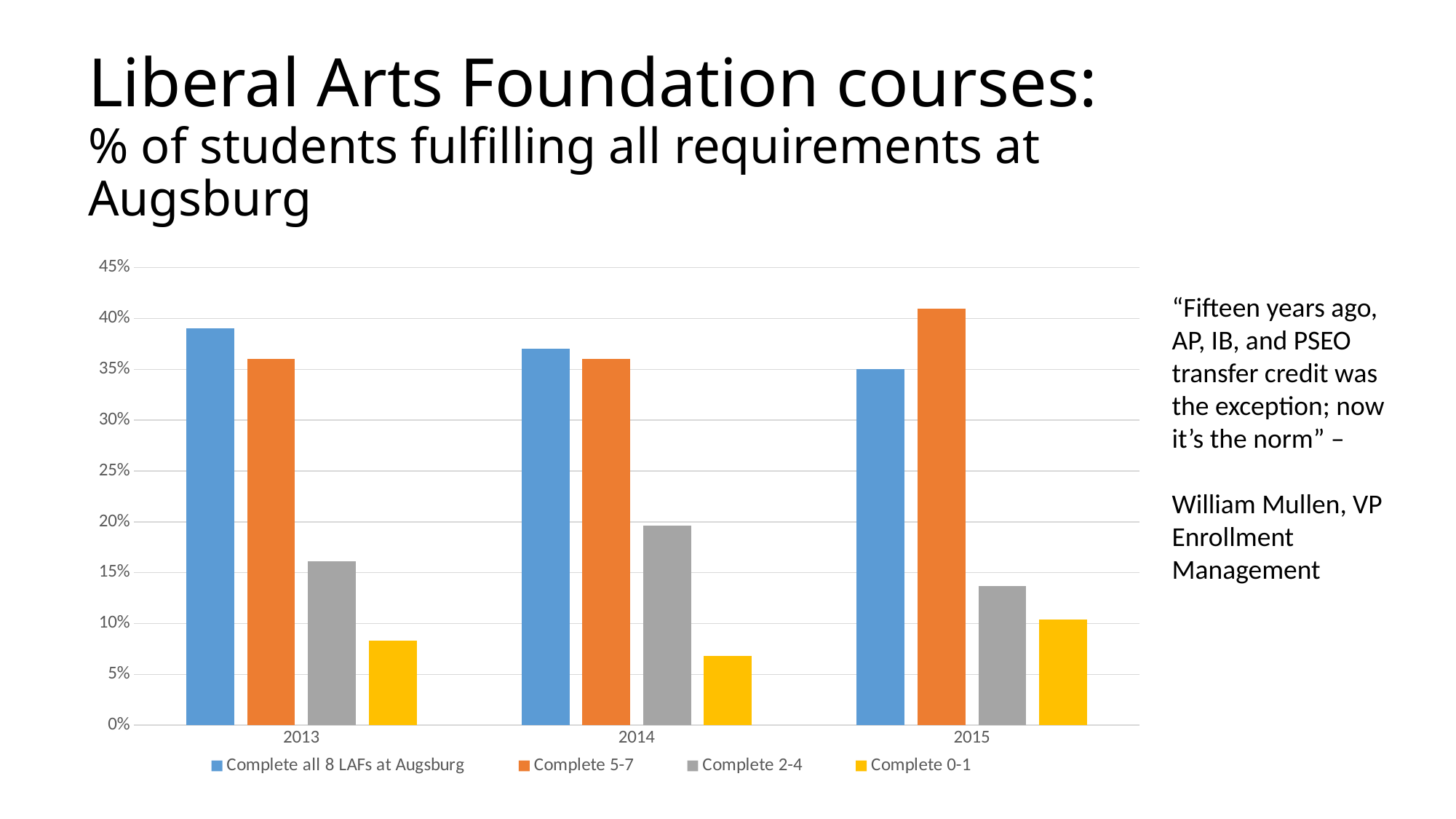
Is the value for Complete 0-1 in 2014 greater or less than 10%? less Which series has the highest value in 2015? Complete 5-7 Does the value for Complete all 8 LAFs at Augsburg rise or fall from 2013 to 2015? fall Which year has the larger value for Complete 2-4, 2014 or 2015? 2014 Is the value for Complete 5-7 in 2015 greater or less than 35%? greater How many series does the legend list? 4 How many years are shown on the x axis? 3 Is the value for Complete 2-4 in 2014 greater or less than 15%? greater What colour represents Complete 0-1 in the legend? yellow What kind of chart is shown on the slide? bar chart Which series has the highest value in 2013? Complete all 8 LAFs at Augsburg Which series has the lowest value in 2014? Complete 0-1